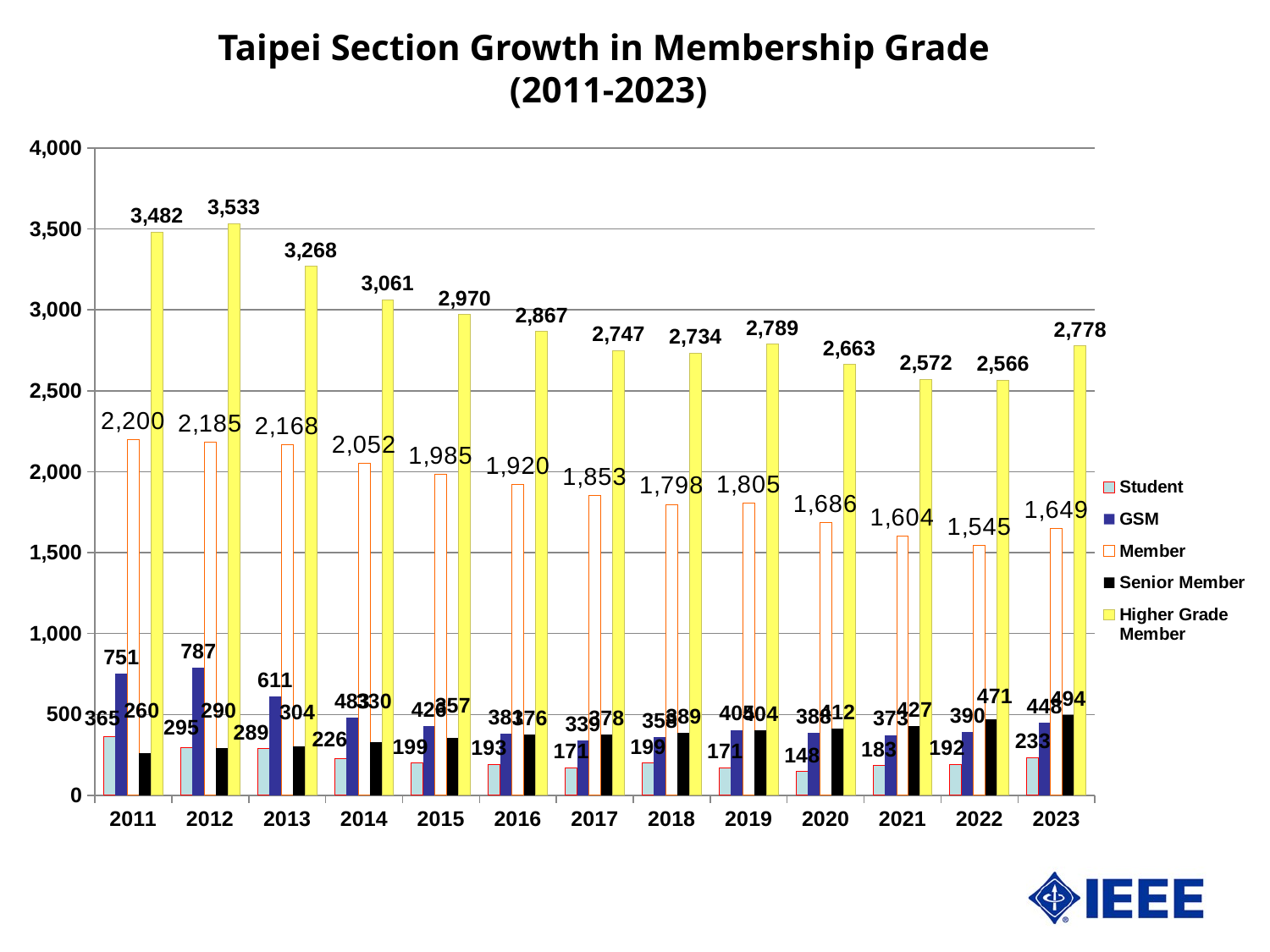
How many series does the legend list? 5 Does the Member value rise or fall from 2011 to 2022? Fall What kind of chart is shown on the slide? Bar chart How many years are shown on the x axis? 13 What is the Higher Grade Member value for 2011? 3,482 What is the GSM value for 2012? 787 What colour are the Higher Grade Member bars? Yellow Which year has the larger Higher Grade Member value, 2018 or 2019? 2019 In which year is the Higher Grade Member value highest? 2012 What is the Member value for 2023? 1,649 In which year is the Higher Grade Member value lowest? 2022 What is the difference between the Higher Grade Member values for 2011 and 2023? 704